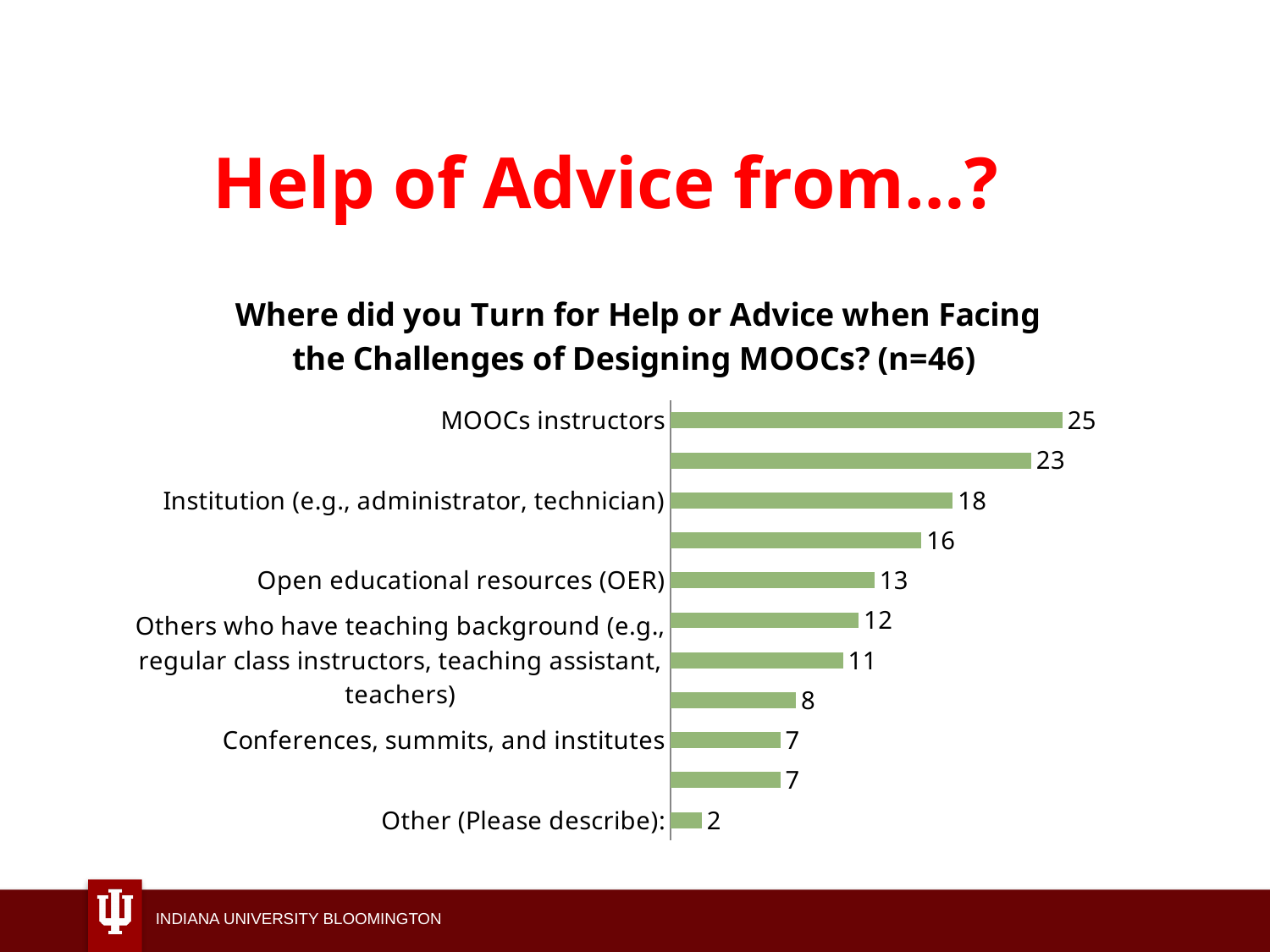
Which is larger, the value for Open educational resources (OER) or the value for Conferences, summits, and institutes? Open educational resources (OER) What kind of chart is shown on the slide? bar chart What is the difference between the values for MOOCs instructors and Institution (e.g., administrator, technician)? 7 What is the value for Other (Please describe)? 2 What is the value for Conferences, summits, and institutes? 7 What is the sample size (n) stated in the chart title? 46 What is the value for Open educational resources (OER)? 13 Which category has the lowest value? Other (Please describe) Which category has the highest value? MOOCs instructors How many bars are plotted in the chart? 11 What is the value for Institution (e.g., administrator, technician)? 18 What is the value for MOOCs instructors? 25